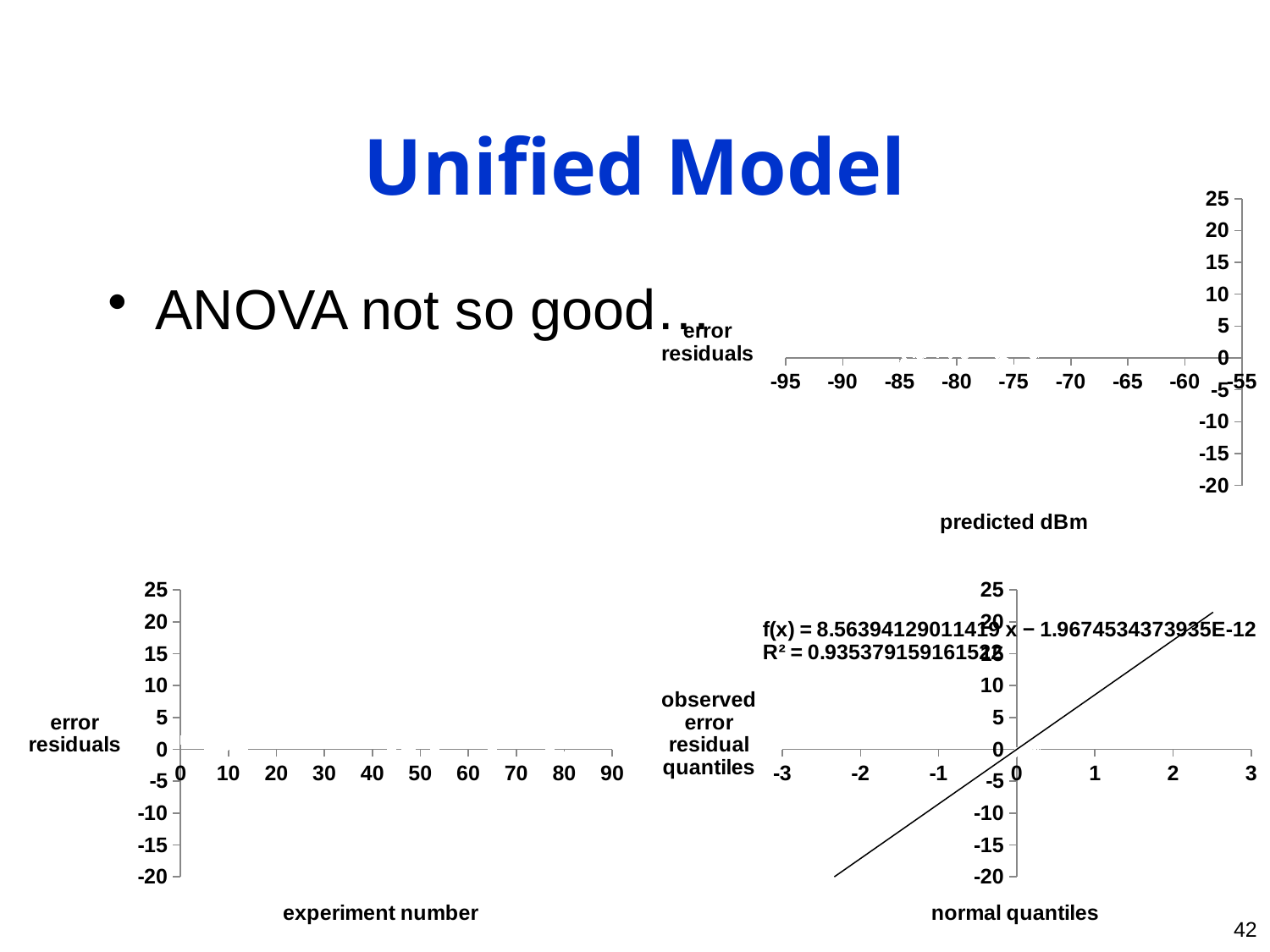
What kind of chart is the top-right chart with x axis 'predicted dBm'? scatter chart What is the x-axis title of the bottom-left chart? experiment number What kind of chart is the bottom-right chart with x axis 'normal quantiles'? scatter chart What kind of chart is the bottom-left chart with x axis 'experiment number'? scatter chart In the bottom-right chart, does the fitted line rise or fall as the normal quantiles increase? rises What is the x-axis title of the top-right chart? predicted dBm